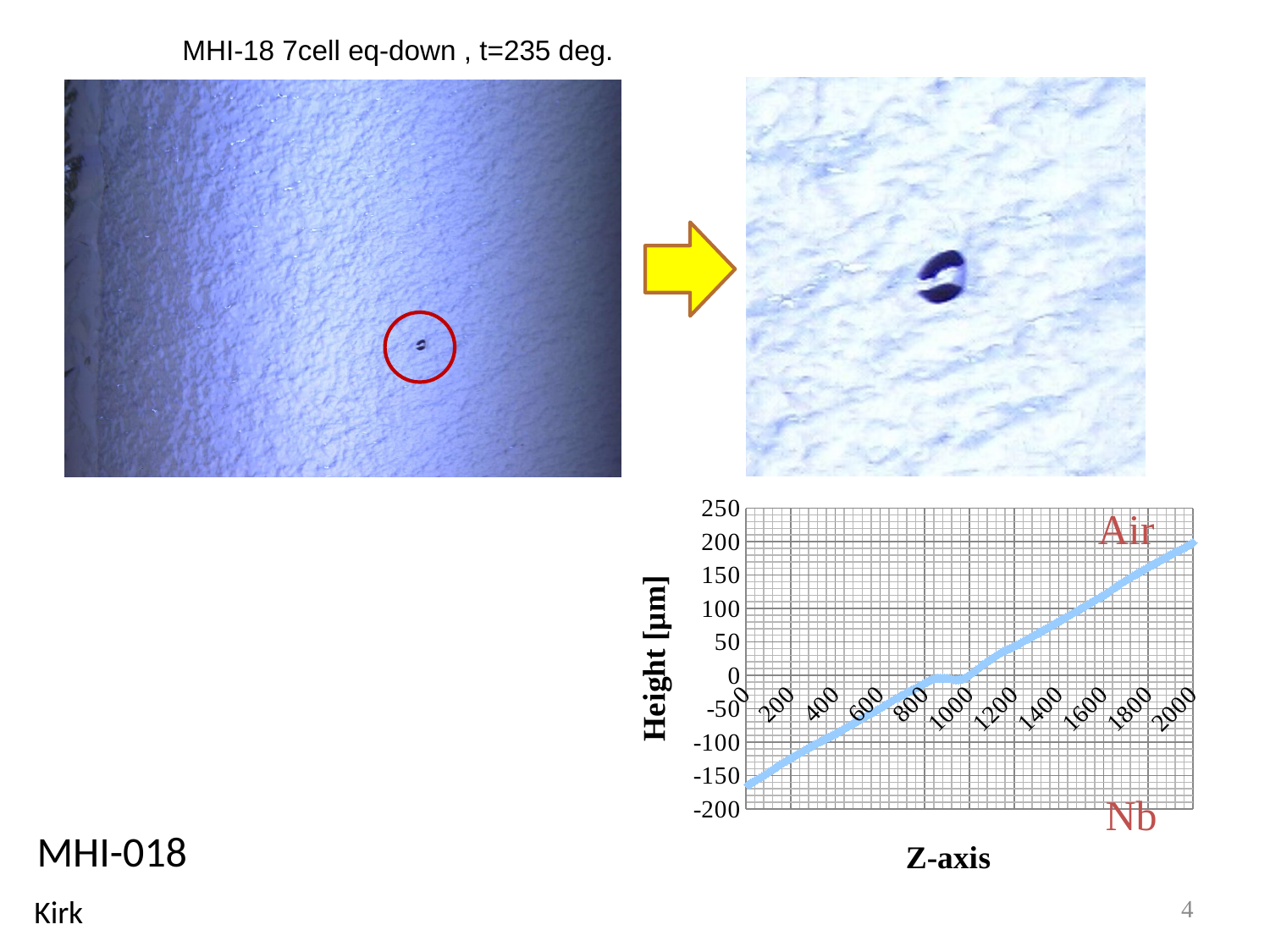
What kind of chart is shown on the slide? line chart Is the height at Z-axis = 2000 greater or less than 150? greater What is the label of the horizontal axis of the chart? Z-axis What is the label of the vertical axis of the chart? Height [µm] Is the height at Z-axis = 1000 greater or less than 50? less Is the height at Z-axis = 400 greater or less than 0? less Which of the two Z-axis positions has the larger height, Z = 200 or Z = 1400? Z = 1400 What is the maximum value shown on the vertical axis of the chart? 250 Does the plotted height rise or fall as the Z-axis value increases from 0 to 2000? rise